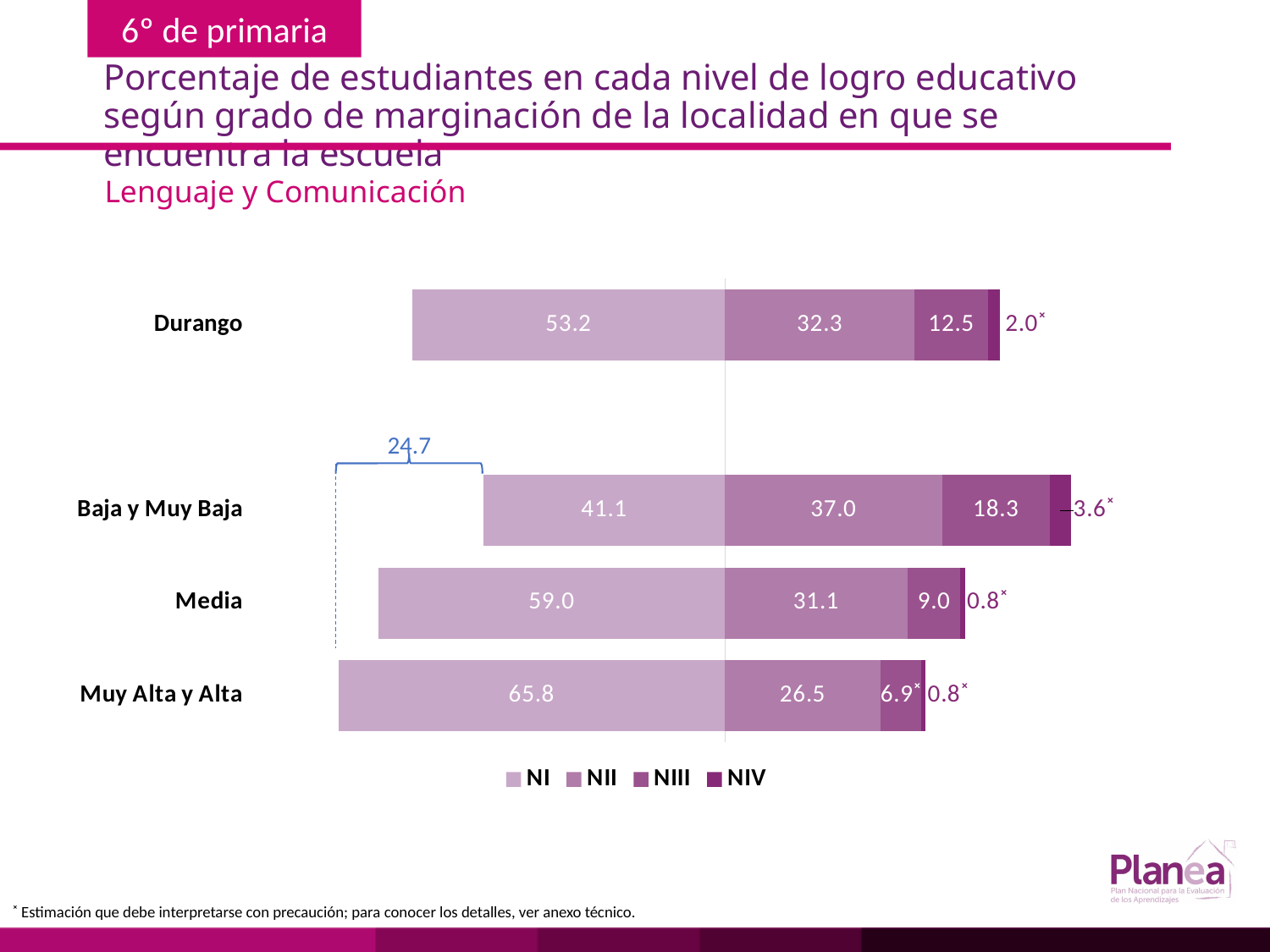
What is the subtitle shown below the chart title, indicating the subject area? Lenguaje y Comunicación What type of chart is shown on the slide? Stacked bar chart What is the NII value for Baja y Muy Baja? 37.0 Which category has the highest NI value? Muy Alta y Alta How many series does the legend list? 4 What is the NI value for Durango? 53.2 What is the NIII value for Media? 9.0 Which category has the lowest NIII value? Muy Alta y Alta Which is larger, the NII value for Durango or the NII value for Media? Durango How many categories (bars) are shown in the chart? 4 What is the difference between the NI value for Muy Alta y Alta and the NI value for Baja y Muy Baja? 24.7 What is the NIV value for Muy Alta y Alta? 0.8